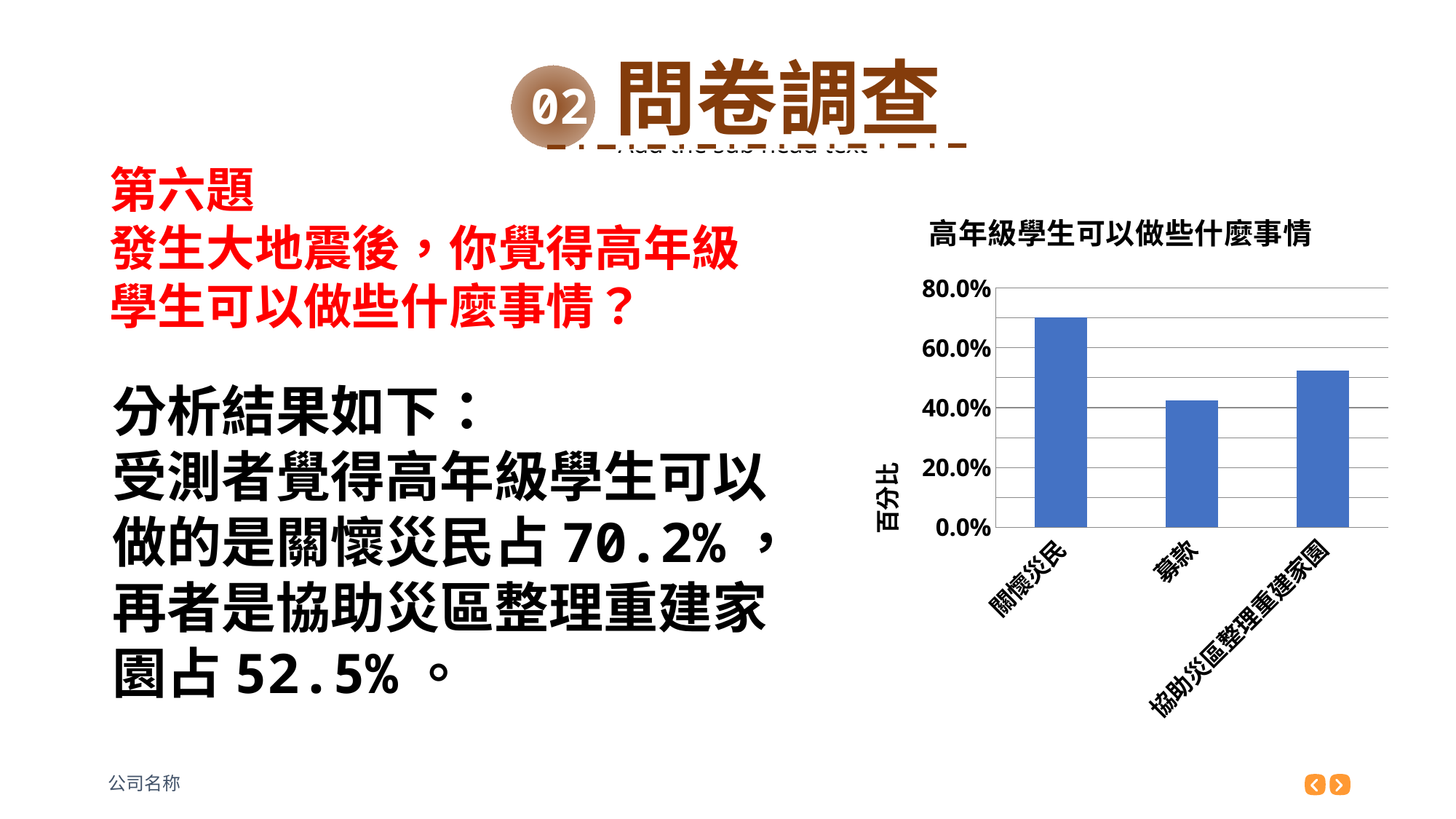
What is the difference between the values for 關懷災民 and 協助災區整理重建家園? 17.7% What is the title of the chart? 高年級學生可以做些什麼事情 Is the value for 募款 greater or less than 40.0%? greater What kind of chart is shown on the slide? bar chart According to the slide, what percentage is shown for 關懷災民? 70.2% Which category has the lowest value in the chart? 募款 Is the value for 募款 greater or less than 60.0%? less How many categories are shown in the chart? 3 Which is larger, the value for 募款 or the value for 協助災區整理重建家園? 協助災區整理重建家園 What is the label of the vertical axis of the chart? 百分比 According to the slide, what percentage is shown for 協助災區整理重建家園? 52.5% Which category has the highest value in the chart? 關懷災民